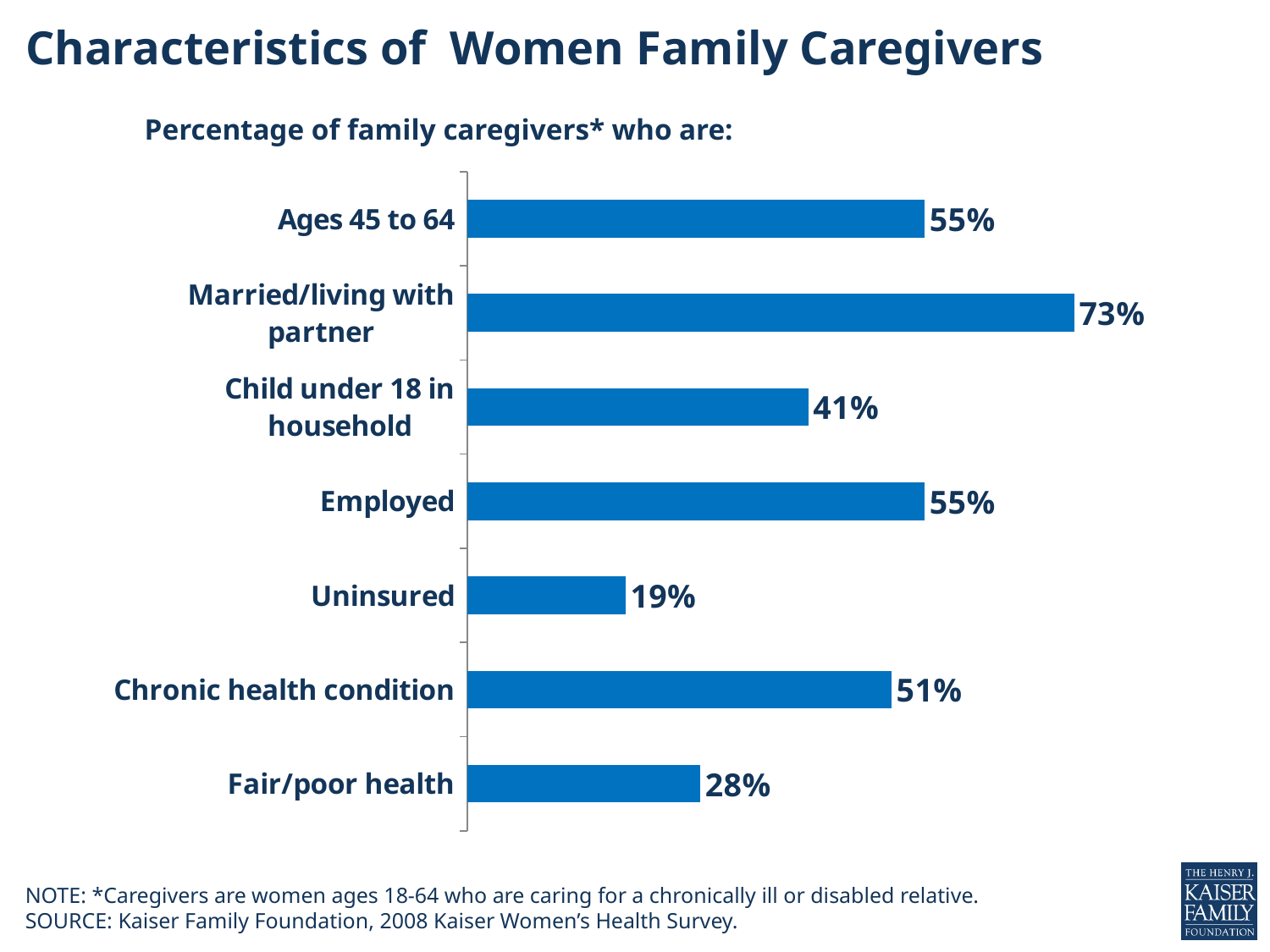
What is the difference in percentage points between caregivers with a chronic health condition and those in fair/poor health? 23 What percentage of family caregivers are uninsured? 19% Which characteristic has the lowest percentage of family caregivers? Uninsured What percentage of family caregivers report fair/poor health? 28% How many characteristics are shown in the chart? 7 What is the difference in percentage points between caregivers who are married/living with a partner and those who are employed? 18 Which characteristic has the highest percentage of family caregivers? Married/living with partner What is the subtitle shown above the chart? Percentage of family caregivers* who are: Which is larger: the percentage of caregivers with a chronic health condition or the percentage with a child under 18 in the household? Chronic health condition What percentage of family caregivers have a child under 18 in the household? 41% What type of chart is shown on the slide? Bar chart What percentage of family caregivers are married or living with a partner? 73%